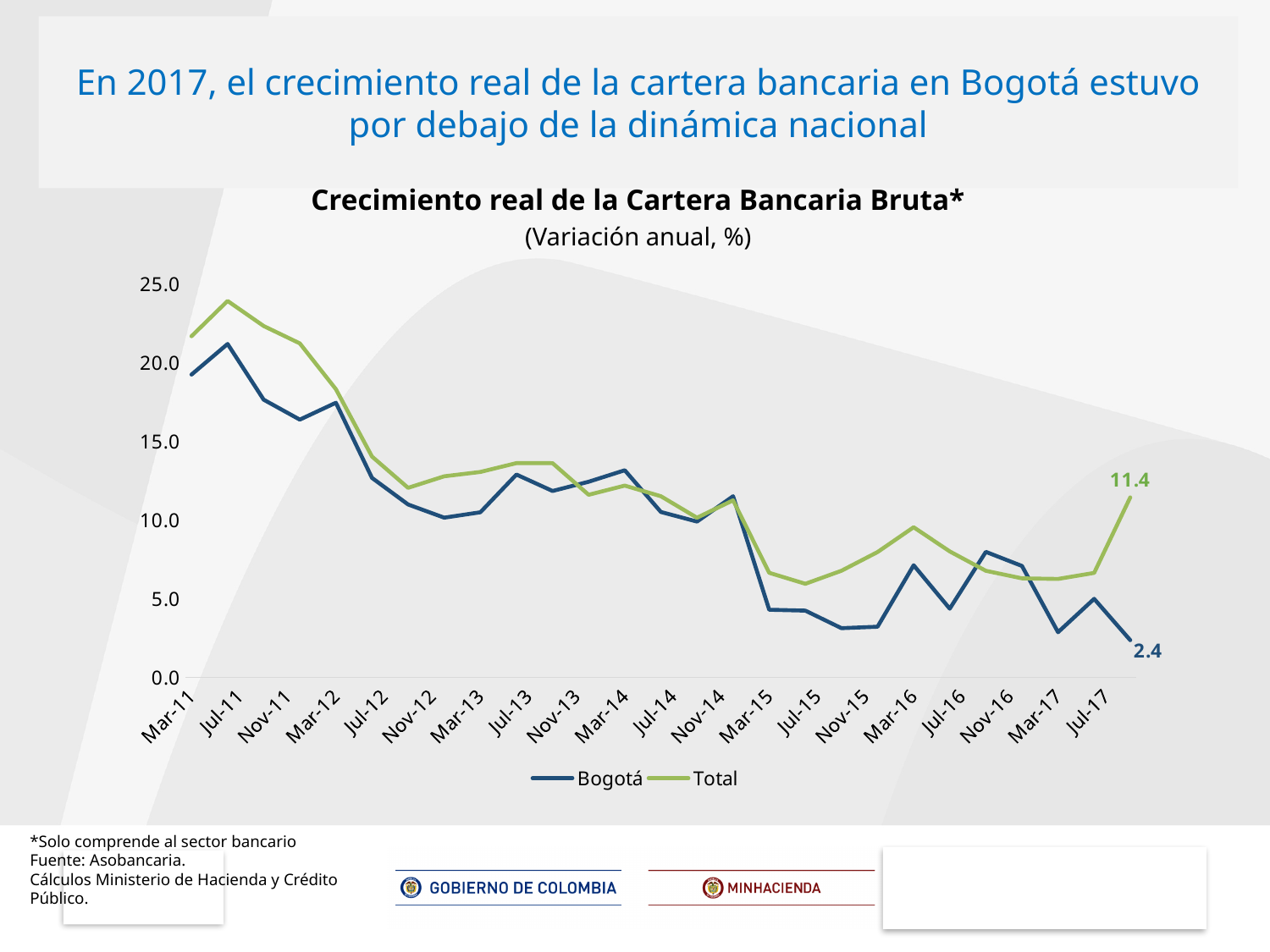
What is the value of the Total series at Jul-17? 11.4 Is the value for Bogotá at Mar-11 greater or less than 15.0? greater Is the value for Total at Jul-15 greater or less than 10.0? less How many series does the legend list? 2 How many date labels are shown on the x axis? 20 What kind of chart is shown on the slide? Line chart At Jul-17, which series has the larger value, Bogotá or Total? Total Is the value for Total at Jul-11 greater or less than 20.0? greater Does the Bogotá series overall rise or fall from Mar-11 to Jul-17? Fall What is the value of the Bogotá series at Jul-17? 2.4 Which series reaches the highest value on the chart? Total What is the difference between the Total and Bogotá values at Jul-17? 9.0